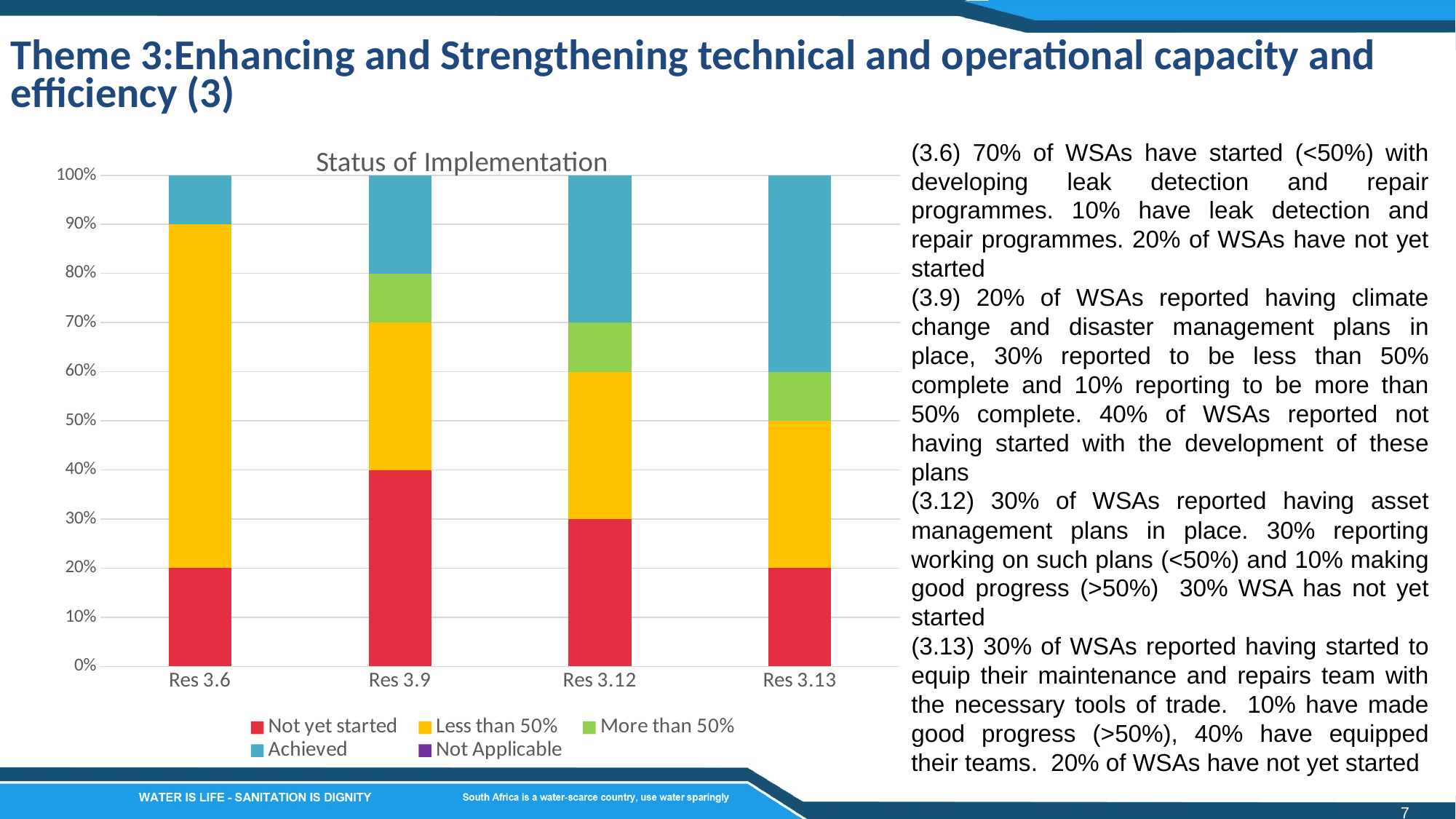
What is the title of the chart? Status of Implementation What is the 'Not yet started' value for Res 3.6? 20% What kind of chart is shown on the slide? Stacked bar chart How many categories are shown on the x axis of the Status of Implementation chart? 4 Which category has the largest 'Achieved' segment? Res 3.13 How many series does the legend of the Status of Implementation chart list? 5 What is the 'Less than 50%' value for Res 3.6? 70% Which colour represents the 'Not yet started' series in the chart? Red Which category has the smallest 'Achieved' segment? Res 3.6 What is the 'Not yet started' value for Res 3.9? 40% What is the 'Achieved' value for Res 3.13? 40% Which has the larger 'Not yet started' value, Res 3.9 or Res 3.12? Res 3.9